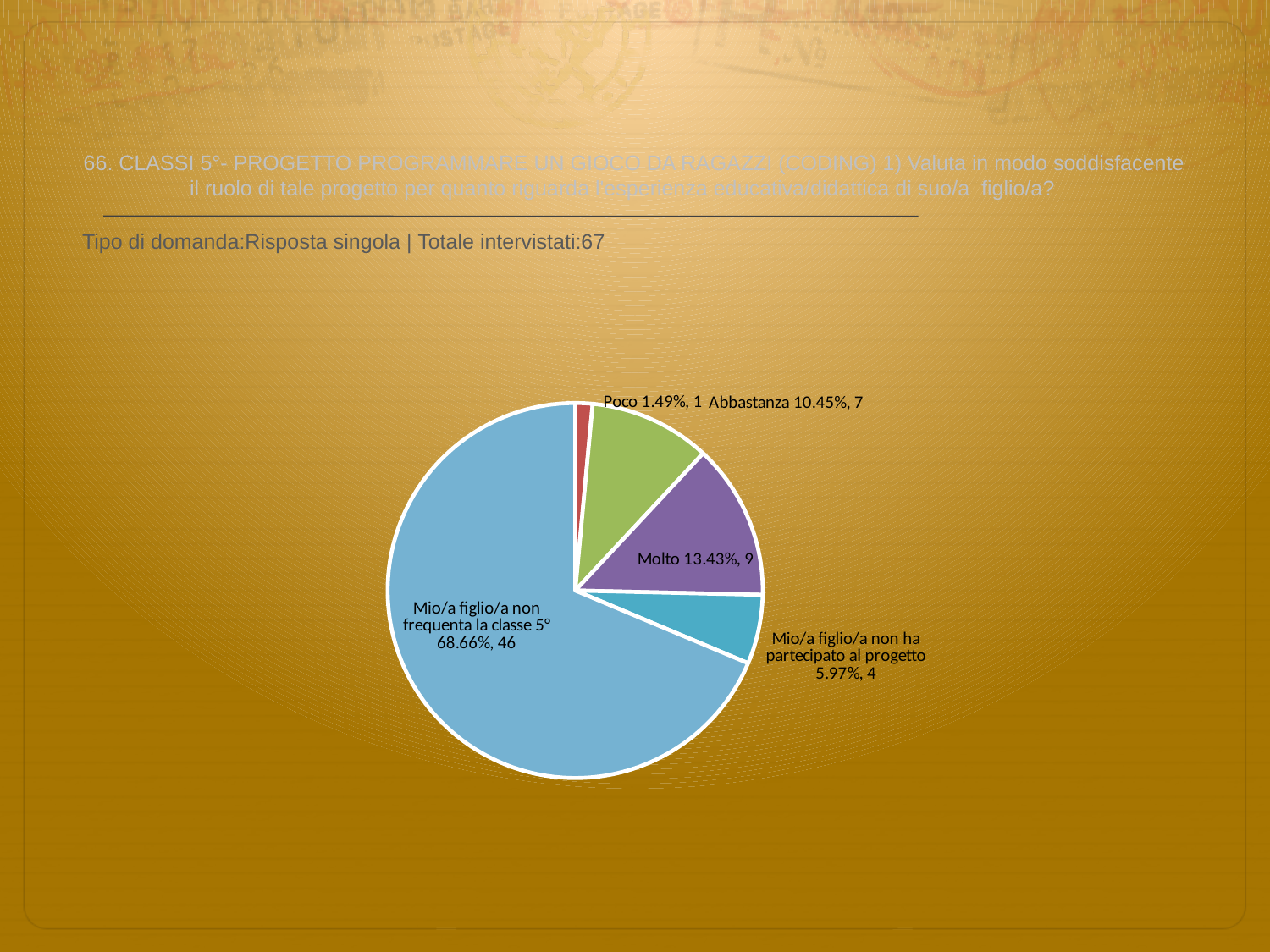
How many slices does the pie chart have? 5 How many respondents are in the "Mio/a figlio/a non frequenta la classe 5°" slice? 46 Which category has the smallest slice of the pie? Poco Which has more respondents, "Molto" or "Abbastanza"? Molto What kind of chart is shown on the slide? Pie chart What is the total number of respondents (Totale intervistati) stated on the slide? 67 What percentage share does the "Molto" slice have? 13.43% What is the difference in number of respondents between "Molto" and "Mio/a figlio/a non ha partecipato al progetto"? 5 Which category has the largest slice of the pie? Mio/a figlio/a non frequenta la classe 5° How many respondents answered "Abbastanza"? 7 What percentage share does the "Mio/a figlio/a non ha partecipato al progetto" slice have? 5.97% What percentage share does the "Poco" slice have? 1.49%